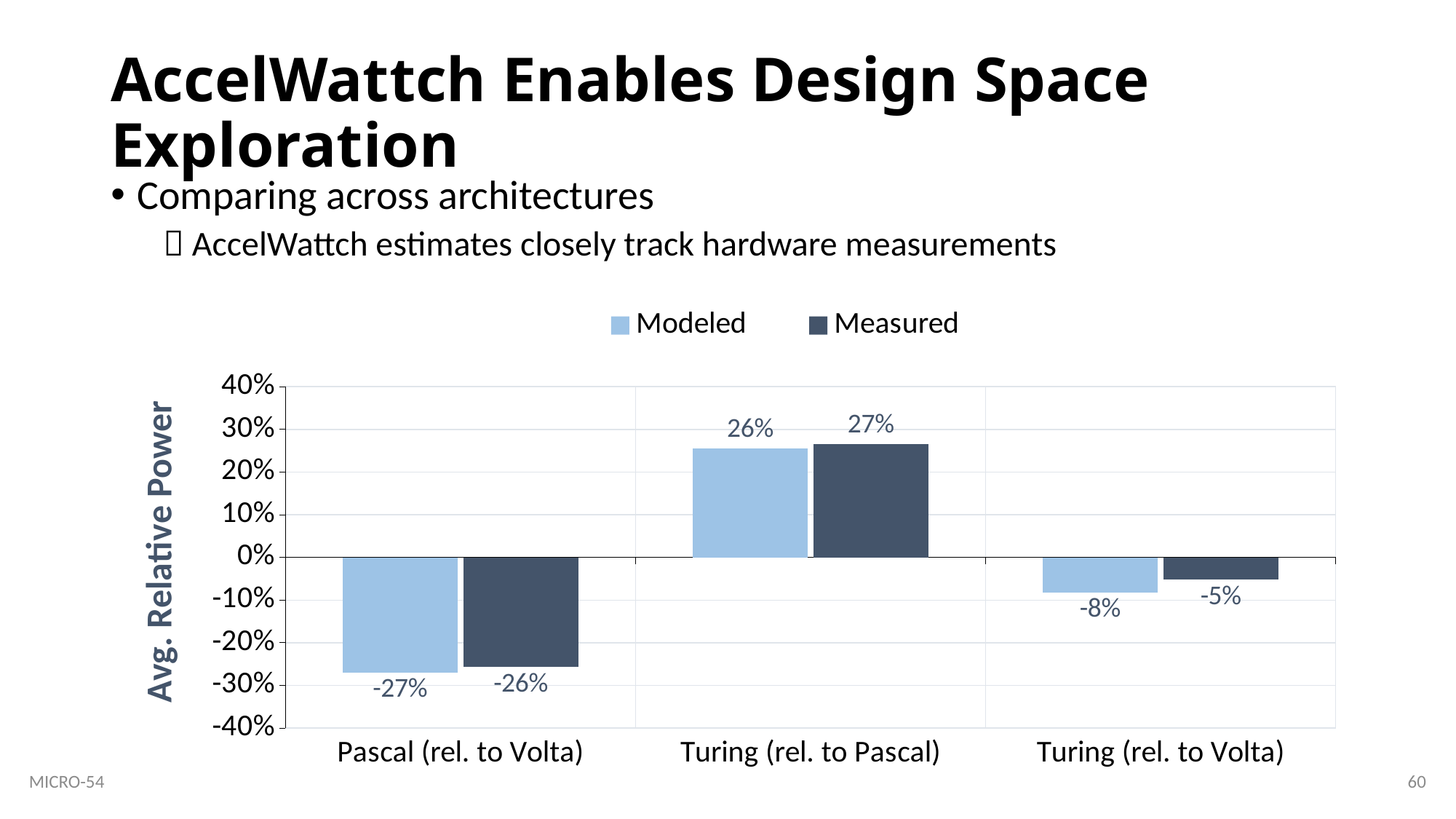
What is the Modeled value for Turing (rel. to Volta)? -8% For Turing (rel. to Pascal), which is larger, the Modeled or the Measured value? Measured What is the Measured value for Turing (rel. to Pascal)? 27% How many series does the legend list? 2 What is the difference between the Modeled and Measured values for Turing (rel. to Volta)? 3% Which category has the lowest Modeled value? Pascal (rel. to Volta) What kind of chart is shown on the slide? Bar chart What is the Modeled value for Pascal (rel. to Volta)? -27% How many categories are shown on the x axis? 3 Which category has the highest Measured value? Turing (rel. to Pascal) What is the Measured value for Turing (rel. to Volta)? -5% What is the label of the y axis? Avg. Relative Power